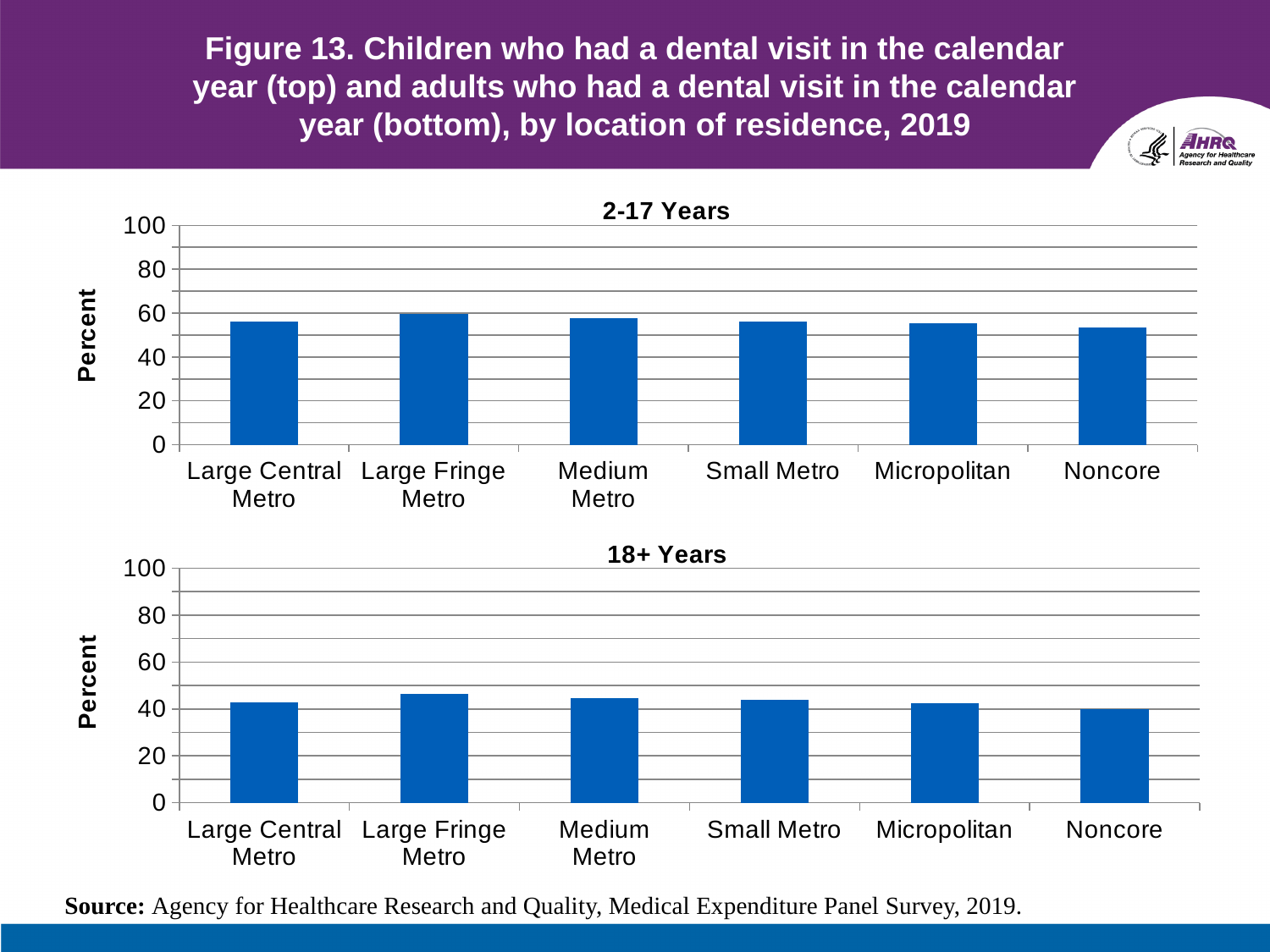
In the bottom chart (18+ Years), is the value for Large Fringe Metro greater or less than 60? less How many location-of-residence categories are shown in the bottom chart titled "18+ Years"? 6 In the top chart (2-17 Years), which location of residence has the highest percentage? Large Fringe Metro In the bottom chart (18+ Years), is the value for Medium Metro greater or less than 20? greater In the bottom chart (18+ Years), which location of residence has the lowest percentage? Noncore In the bottom chart (18+ Years), which is larger, the value for Large Fringe Metro or the value for Noncore? Large Fringe Metro In the top chart (2-17 Years), is the value for Large Central Metro greater or less than 40? greater What is the title of the bottom chart on the slide? 18+ Years What is the label on the vertical axis of the top chart (2-17 Years)? Percent In the top chart (2-17 Years), which is larger, the value for Large Fringe Metro or the value for Noncore? Large Fringe Metro What kind of chart is the top chart titled "2-17 Years"? bar chart